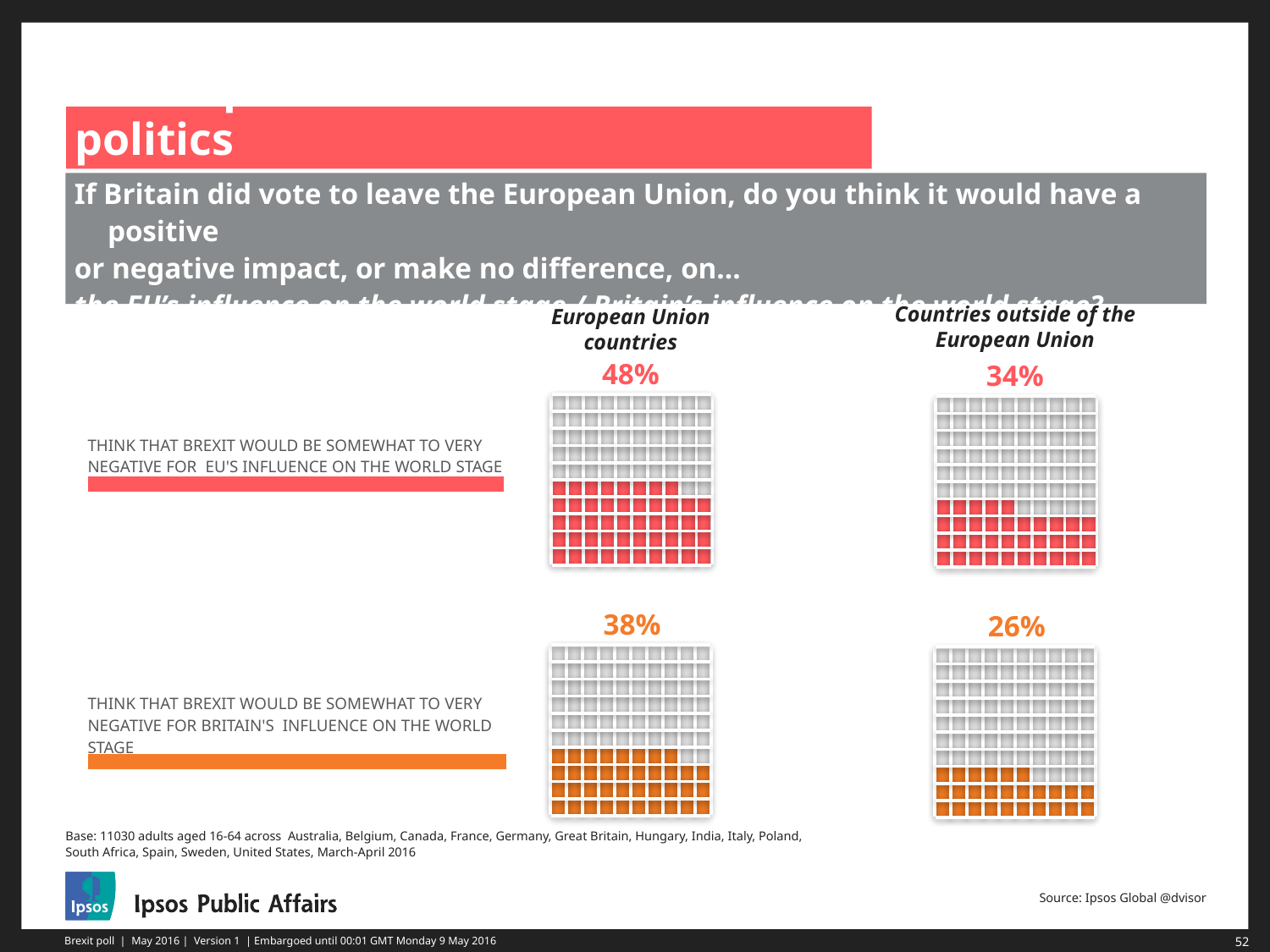
Is the percentage for countries outside of the European Union on Britain's influence on the world stage greater or less than 30%? less What colour are the filled squares in the charts about Britain's influence on the world stage? Orange What percentage of respondents in European Union countries think Brexit would be somewhat to very negative for Britain's influence on the world stage? 38% What percentage of respondents in countries outside of the European Union think Brexit would be somewhat to very negative for the EU's influence on the world stage? 34% What percentage of respondents in countries outside of the European Union think Brexit would be somewhat to very negative for Britain's influence on the world stage? 26% What is the difference between the EU countries and non-EU countries percentages for Brexit being negative for Britain's influence on the world stage? 12 percentage points What is the difference between the EU countries and non-EU countries percentages for Brexit being negative for the EU's influence on the world stage? 14 percentage points In European Union countries, which is larger: the share thinking Brexit would be negative for the EU's influence or the share thinking it would be negative for Britain's influence? EU's influence (48%) Which of the four percentages shown on the slide is the highest? 48% Which of the four percentages shown on the slide is the lowest? 26% How many waffle (grid) charts are shown on the slide? 4 What percentage of respondents in European Union countries think Brexit would be somewhat to very negative for the EU's influence on the world stage? 48%